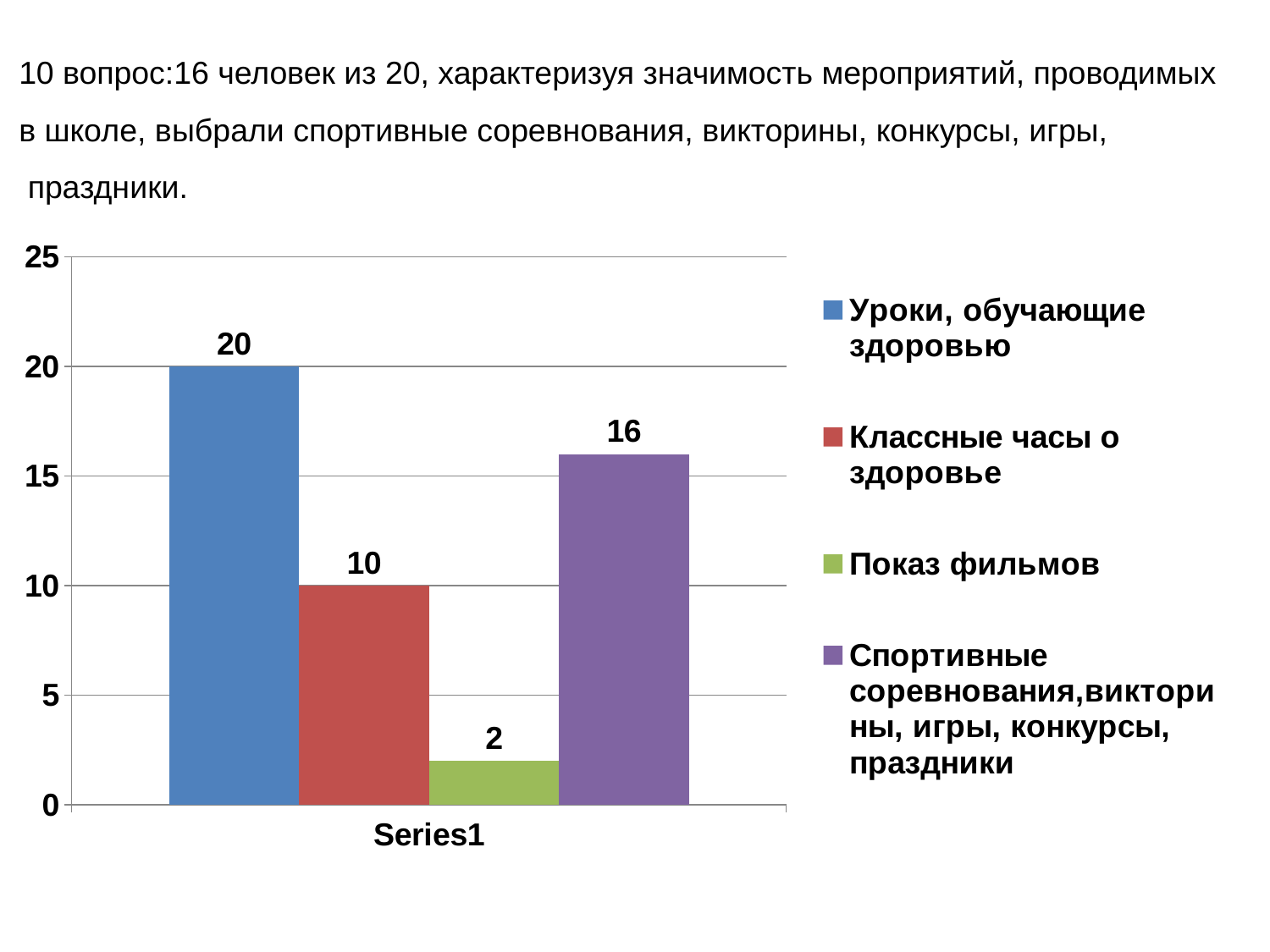
What is the value for "Уроки, обучающие здоровью"? 20 What is the value for "Классные часы о здоровье"? 10 How many bars are plotted in the chart? 4 What is the difference between the values for "Уроки, обучающие здоровью" and "Классные часы о здоровье"? 10 Which is larger: the value for "Классные часы о здоровье" or the value for "Спортивные соревнования,викторины, игры, конкурсы, праздники"? Спортивные соревнования,викторины, игры, конкурсы, праздники What is the value for "Показ фильмов"? 2 Which legend entry has the highest value? Уроки, обучающие здоровью Which legend entry has the lowest value? Показ фильмов What is the label shown on the x axis under the bars? Series1 How many entries does the legend list? 4 What is the value for "Спортивные соревнования,викторины, игры, конкурсы, праздники"? 16 What kind of chart is shown on the slide? Bar chart